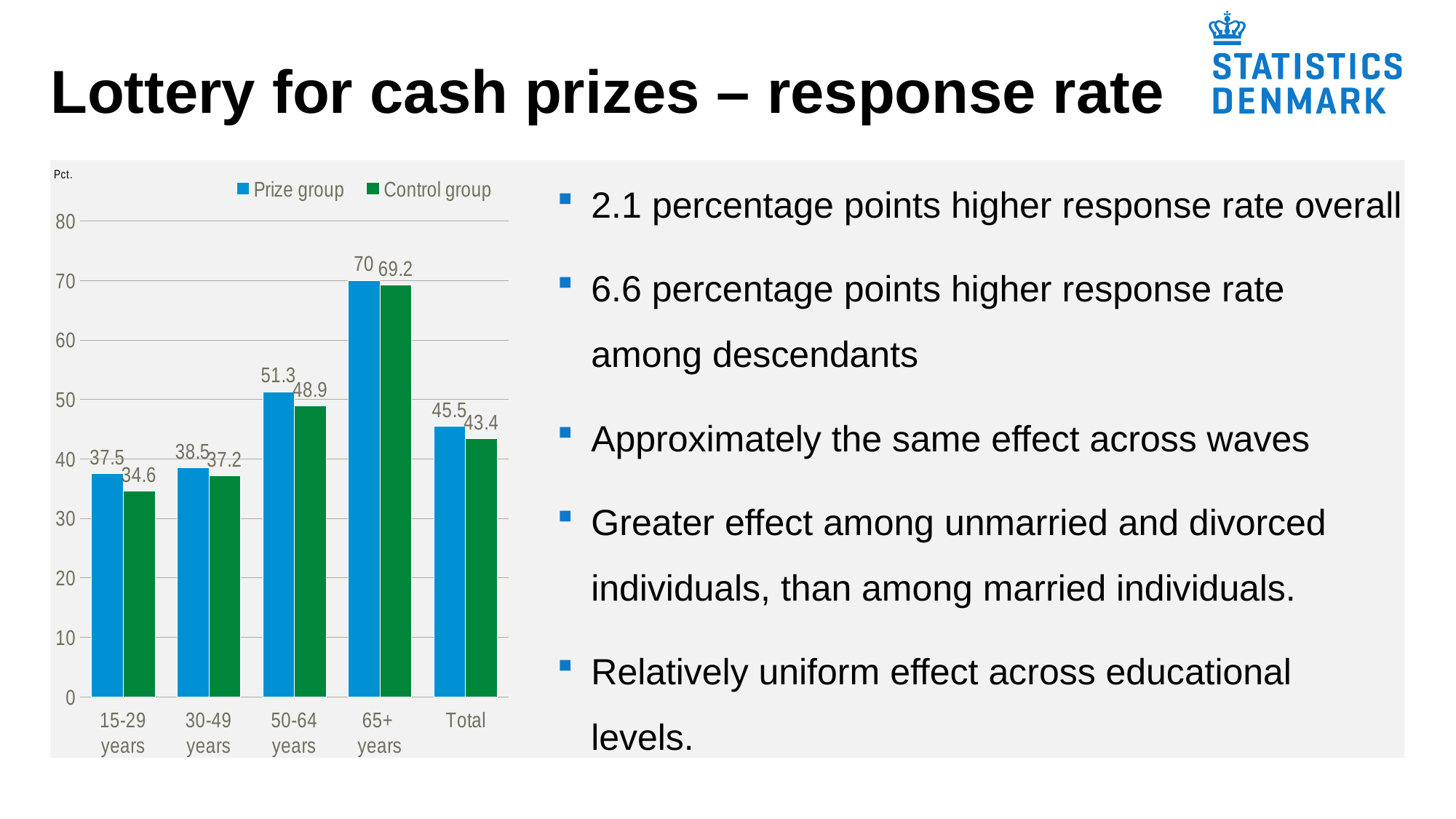
Do the Prize group values rise or fall across the age groups from 15-29 years to 65+ years? rise Is the Control group value for 65+ years greater or less than 60? greater How many categories are shown on the x axis? 5 What is the Prize group value for Total? 45.5 Which category has the lowest Control group value? 15-29 years What is the difference between the Prize group and Control group values for 50-64 years? 2.4 How many series does the legend list? 2 What kind of chart is shown on the slide? bar chart Which age category has the highest Prize group value? 65+ years What is the Control group value for 65+ years? 69.2 What is the Prize group value for 15-29 years? 37.5 Which is larger for 30-49 years, the Prize group or the Control group value? Prize group